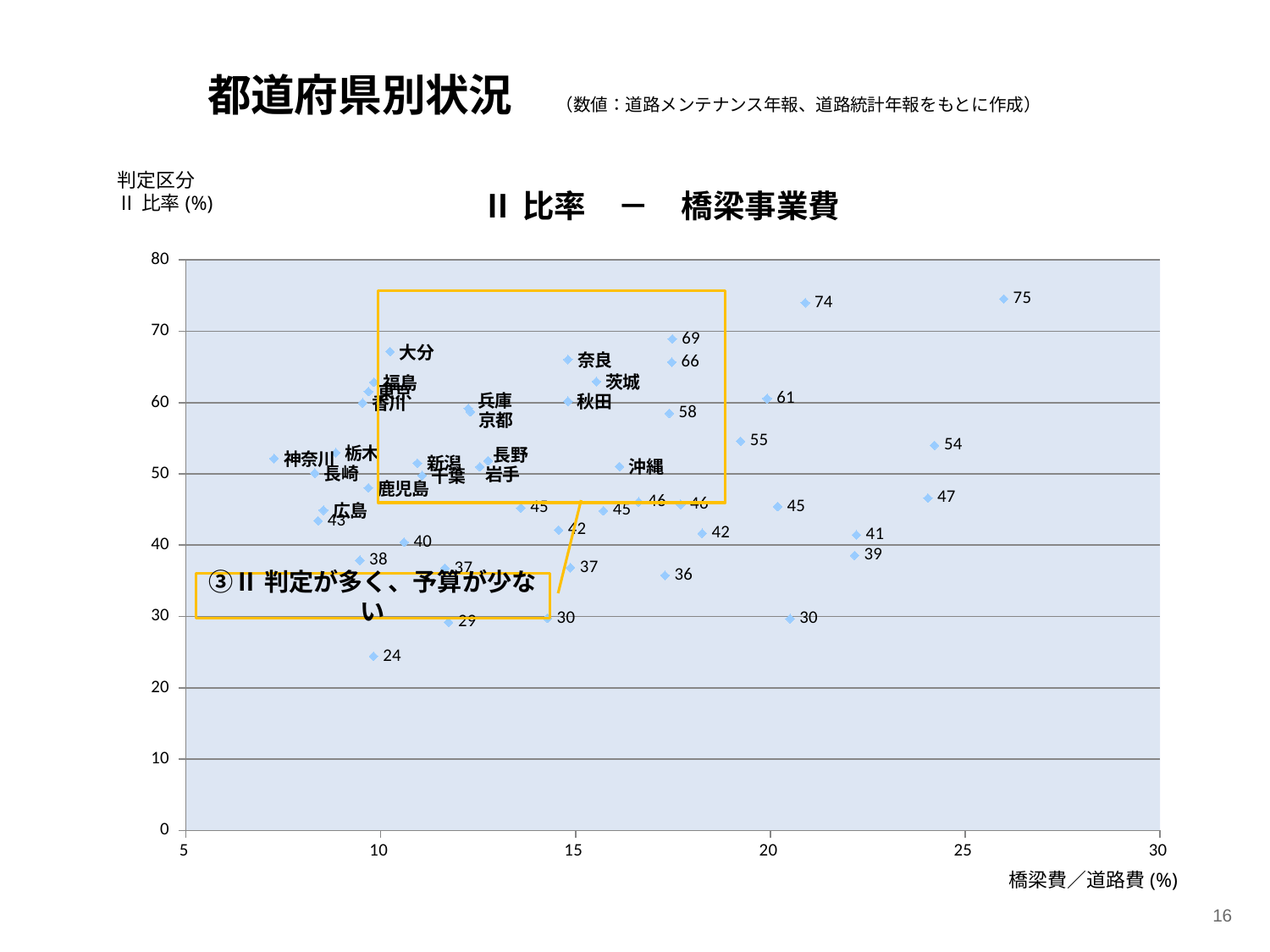
Which labeled point has the larger value, the one labeled 74 or the one labeled 75? 75 What is the maximum value shown on the y axis of the chart? 80 What is the lowest data label value shown on the chart? 24 What is the difference between the highest labeled value (75) and the lowest labeled value (24) on the chart? 51 Is the Ⅱ 比率 value for 奈良 greater or less than 60? greater What is the label of the x axis of the chart? 橋梁費／道路費 (%) What kind of chart is shown on the slide? scatter chart What is the title of the chart? Ⅱ 比率 － 橋梁事業費 What is the highest data label value shown on the chart? 75 Is the Ⅱ 比率 value for 神奈川 greater or less than 60? less Is the Ⅱ 比率 value for 広島 greater or less than 50? less